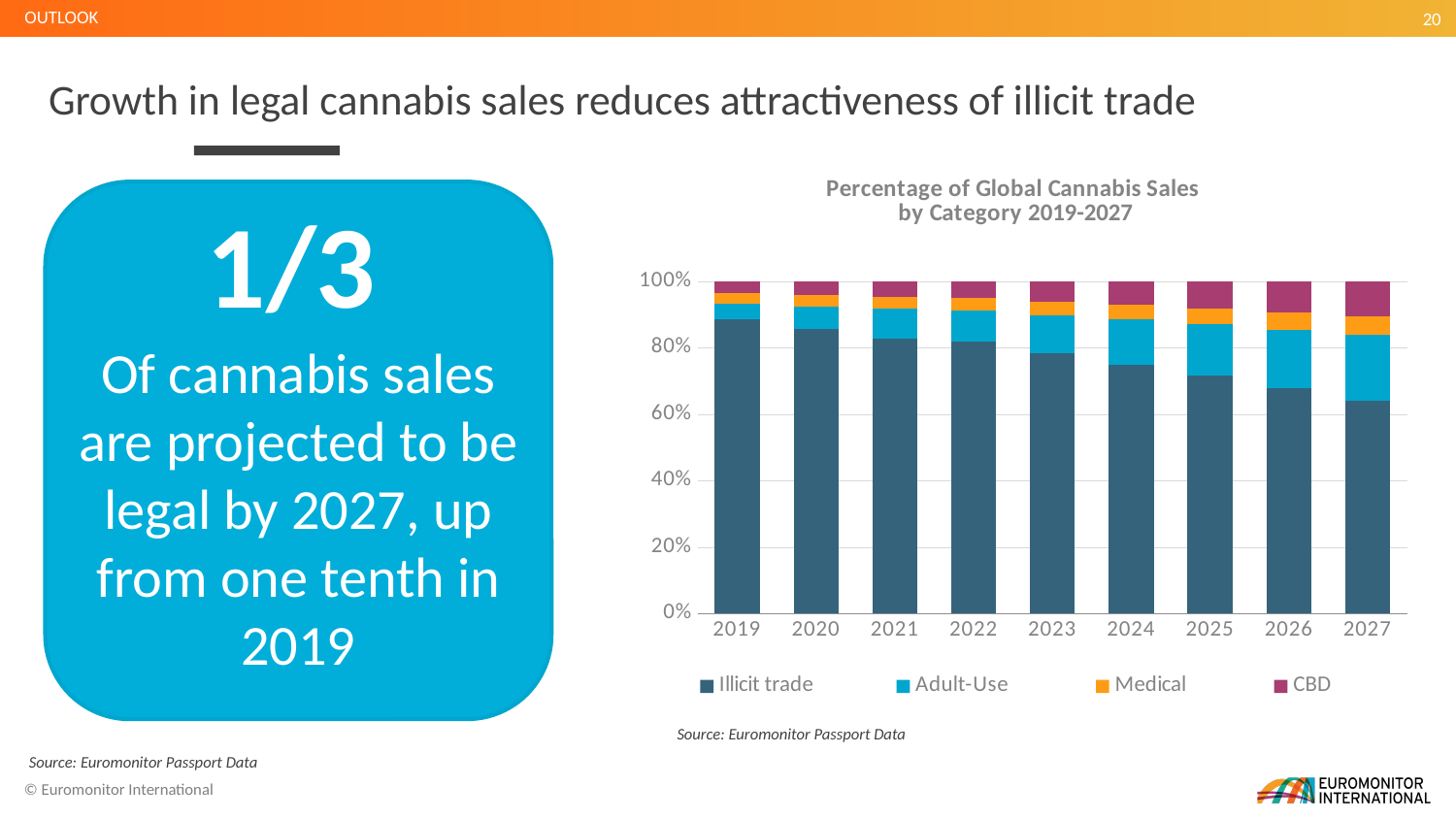
How many years are shown along the x axis of the chart? 9 Which is larger in 2027, the Illicit trade share or the Adult-Use share? Illicit trade Is the Illicit trade share in 2019 greater or less than 80%? greater Is the Illicit trade share in 2027 greater or less than 80%? less Is the Illicit trade share in 2027 greater or less than 60%? greater What is the title of the chart? Percentage of Global Cannabis Sales by Category 2019-2027 How many series does the chart's legend list? 4 Does the Illicit trade share rise or fall from 2019 to 2027? fall Does the Adult-Use share rise or fall from 2019 to 2027? rise What kind of chart is shown on the slide? stacked bar chart In which year is the Illicit trade share the highest? 2019 Which series is listed first in the chart's legend? Illicit trade